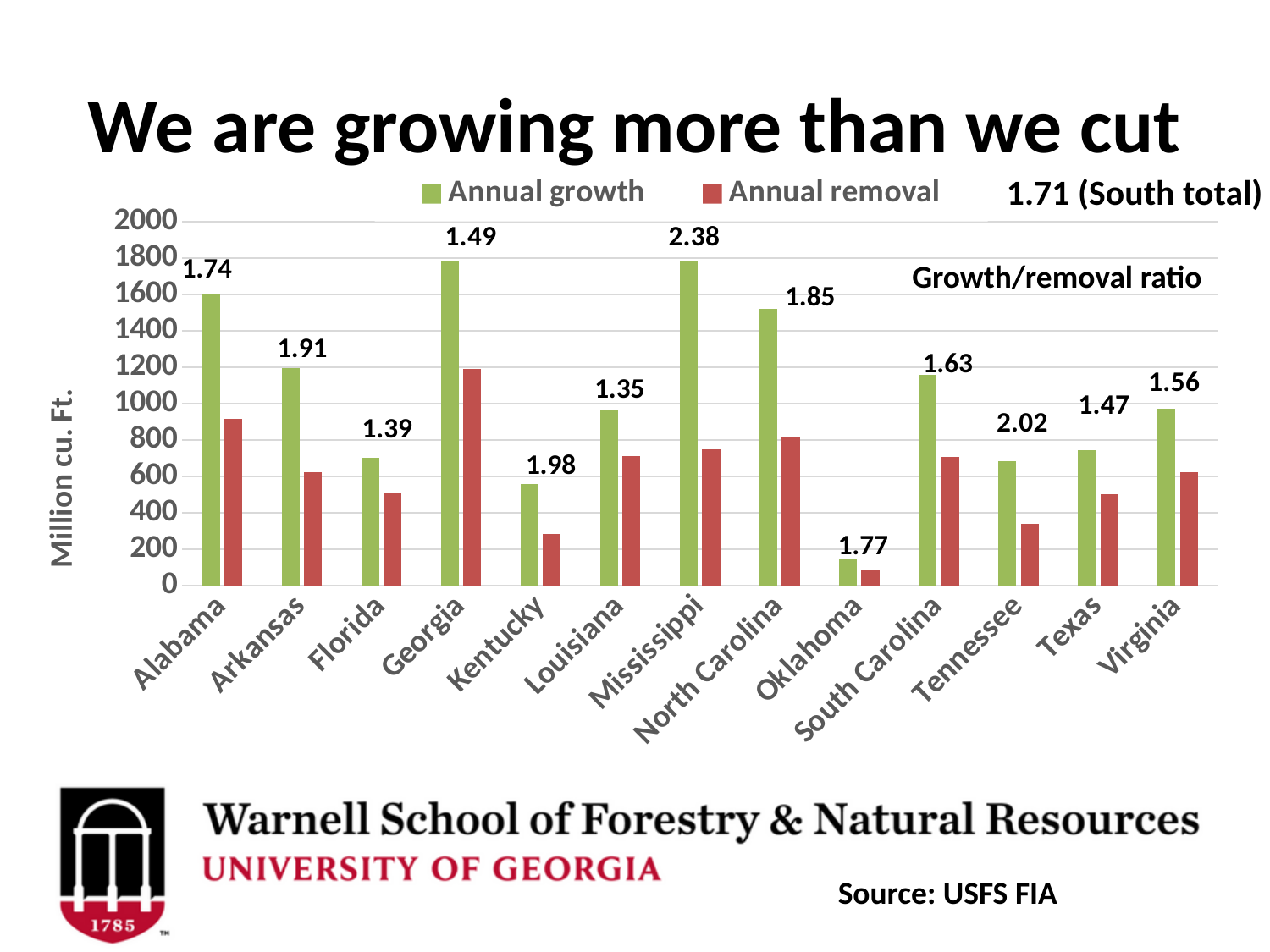
How many series does the legend list? 2 What kind of chart is shown on the slide? bar chart Is the Annual growth value for Alabama greater or less than 1400? greater Is the Annual removal value for Kentucky greater or less than 400? less Which state has the lowest growth/removal ratio label? Louisiana What is the difference between the growth/removal ratios of Mississippi and Louisiana? 1.03 Which state has the highest growth/removal ratio label? Mississippi What is the growth/removal ratio printed for Florida? 1.39 What is the growth/removal ratio printed for Mississippi? 2.38 Which state has the lowest Annual growth bar? Oklahoma How many states are shown on the x axis? 13 What is the growth/removal ratio given for the South total? 1.71